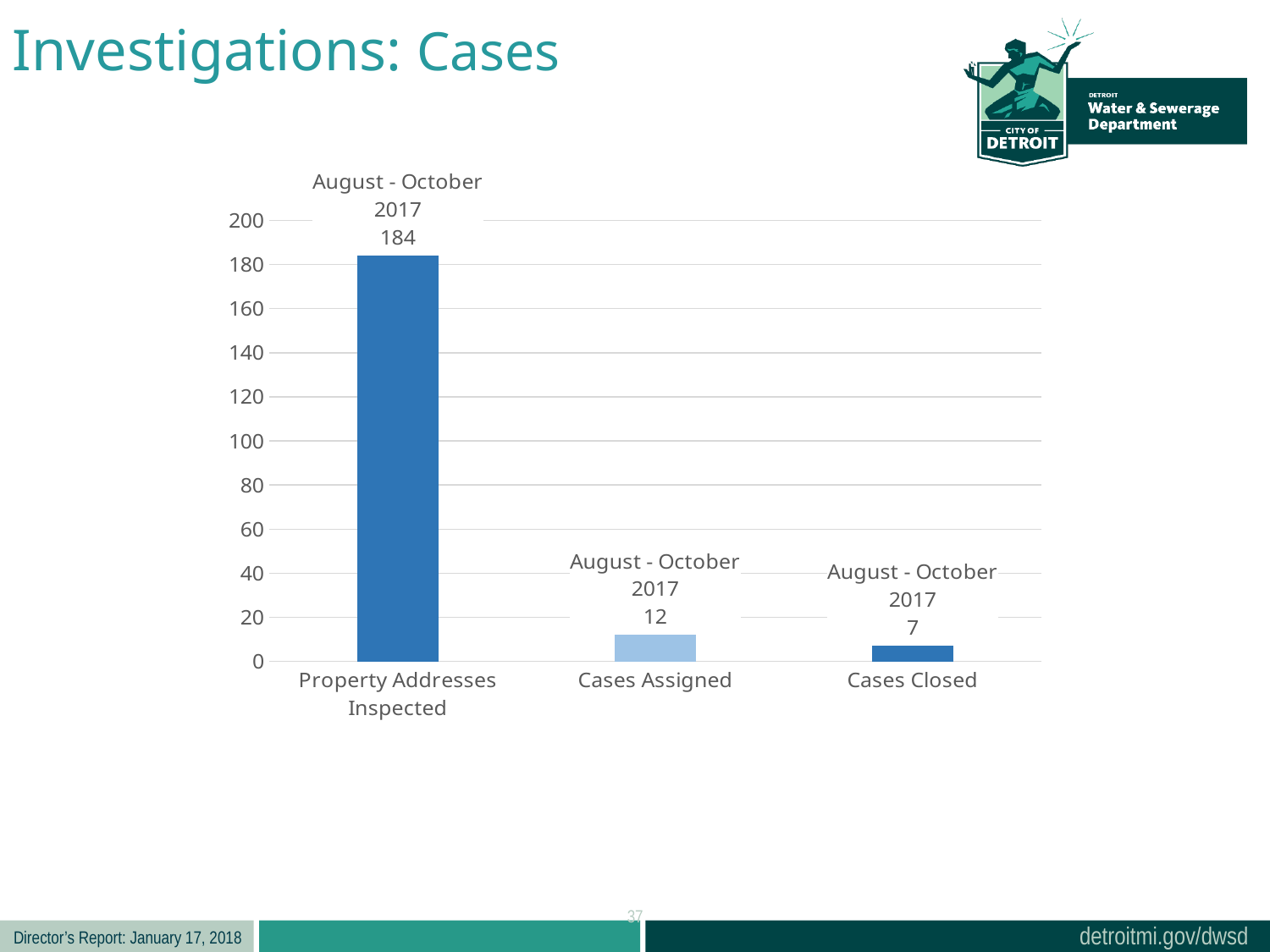
What is the value for Property Addresses Inspected? 184 Which is larger, Cases Assigned or Cases Closed? Cases Assigned What is the value for Cases Closed? 7 What is the difference between Property Addresses Inspected and Cases Assigned? 172 How many categories are shown on the x axis? 3 Which category has the highest value? Property Addresses Inspected What is the difference between Cases Assigned and Cases Closed? 5 Is the value for Property Addresses Inspected greater or less than 160? greater What time period is labelled above each bar? August - October 2017 What is the value for Cases Assigned? 12 Which category has the lowest value? Cases Closed What kind of chart is shown on the slide? bar chart